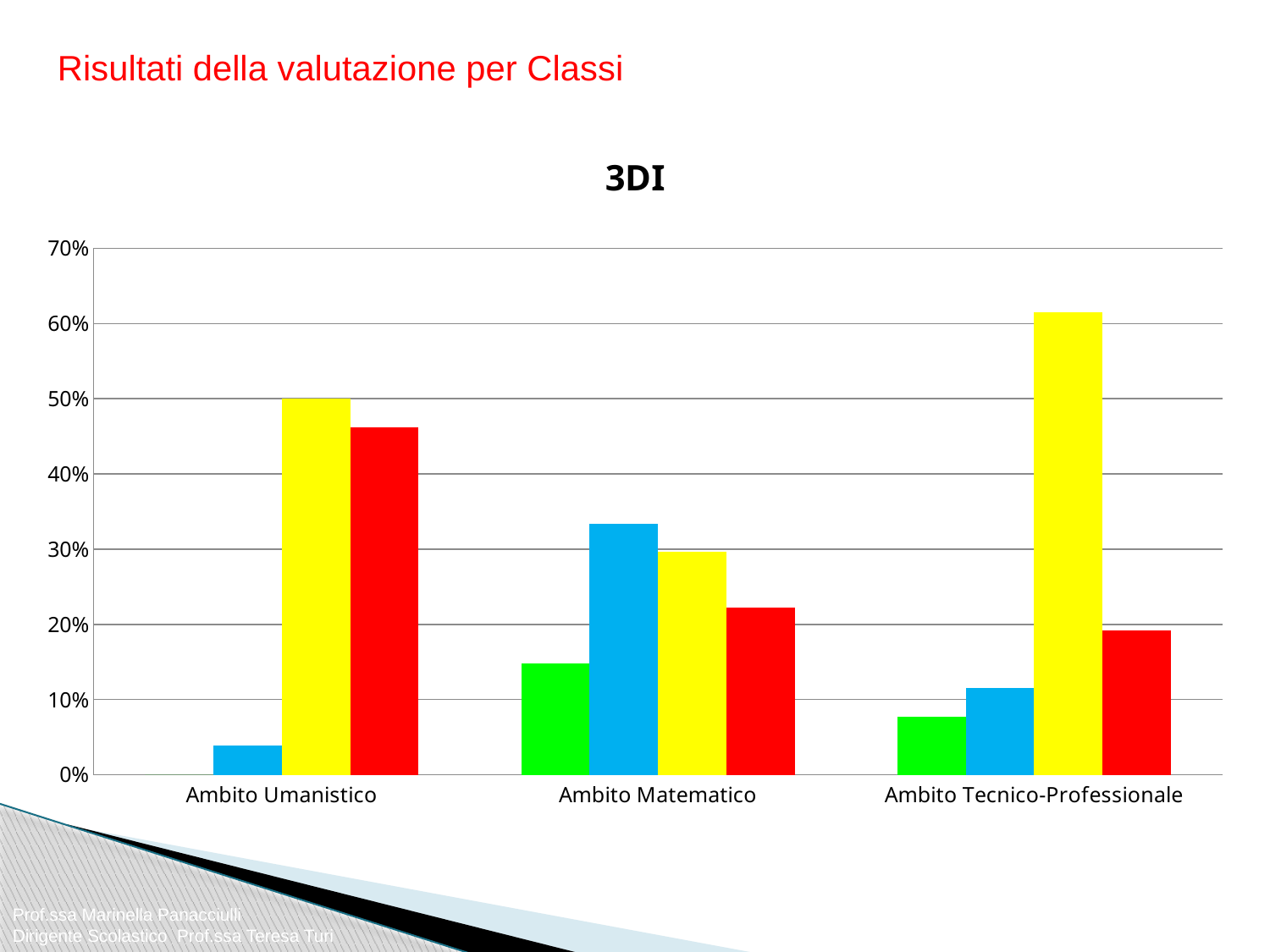
Is the value of the blue bar for Ambito Matematico greater or less than 30%? greater Which is larger for Ambito Matematico, the blue bar or the red bar? the blue bar What kind of chart is shown on the slide? bar chart Is the value of the yellow bar for Ambito Tecnico-Professionale greater or less than 60%? greater Which category has the tallest bar in the chart? Ambito Tecnico-Professionale Is the value of the blue bar for Ambito Umanistico greater or less than 10%? less Which is larger, the yellow bar for Ambito Umanistico or the yellow bar for Ambito Matematico? the yellow bar for Ambito Umanistico What is the title of the chart? 3DI How many categories are shown on the x axis of the chart? 3